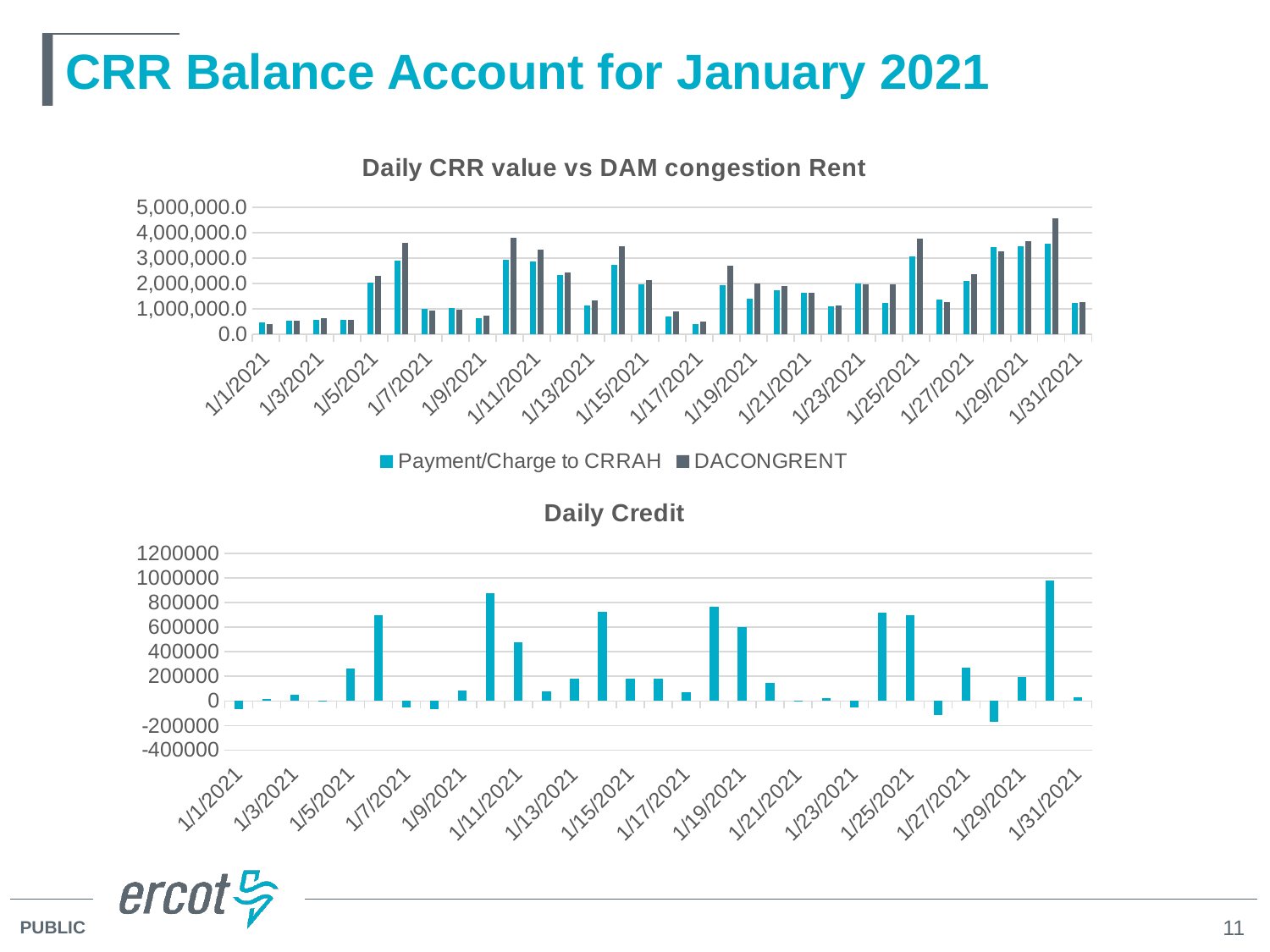
In the 'Daily CRR value vs DAM congestion Rent' chart, is the Payment/Charge to CRRAH value for 1/1/2021 greater or less than 1,000,000.0? less In the 'Daily CRR value vs DAM congestion Rent' chart, what are the two series named in the legend? Payment/Charge to CRRAH and DACONGRENT In the 'Daily CRR value vs DAM congestion Rent' chart, which series contains the tallest bar on the chart? DACONGRENT In the 'Daily Credit' chart, is the value for 1/1/2021 greater or less than 0? less In the 'Daily CRR value vs DAM congestion Rent' chart, which series has the larger value on 1/25/2021? DACONGRENT What kind of chart is the 'Daily CRR value vs DAM congestion Rent' chart? bar chart In the 'Daily CRR value vs DAM congestion Rent' chart, is the DACONGRENT value for 1/11/2021 greater or less than 3,000,000.0? greater How many series does the legend of the 'Daily CRR value vs DAM congestion Rent' chart list? 2 How many dates are labeled on the x axis of the 'Daily Credit' chart? 16 In the 'Daily CRR value vs DAM congestion Rent' chart, which series has the larger value on 1/11/2021? DACONGRENT